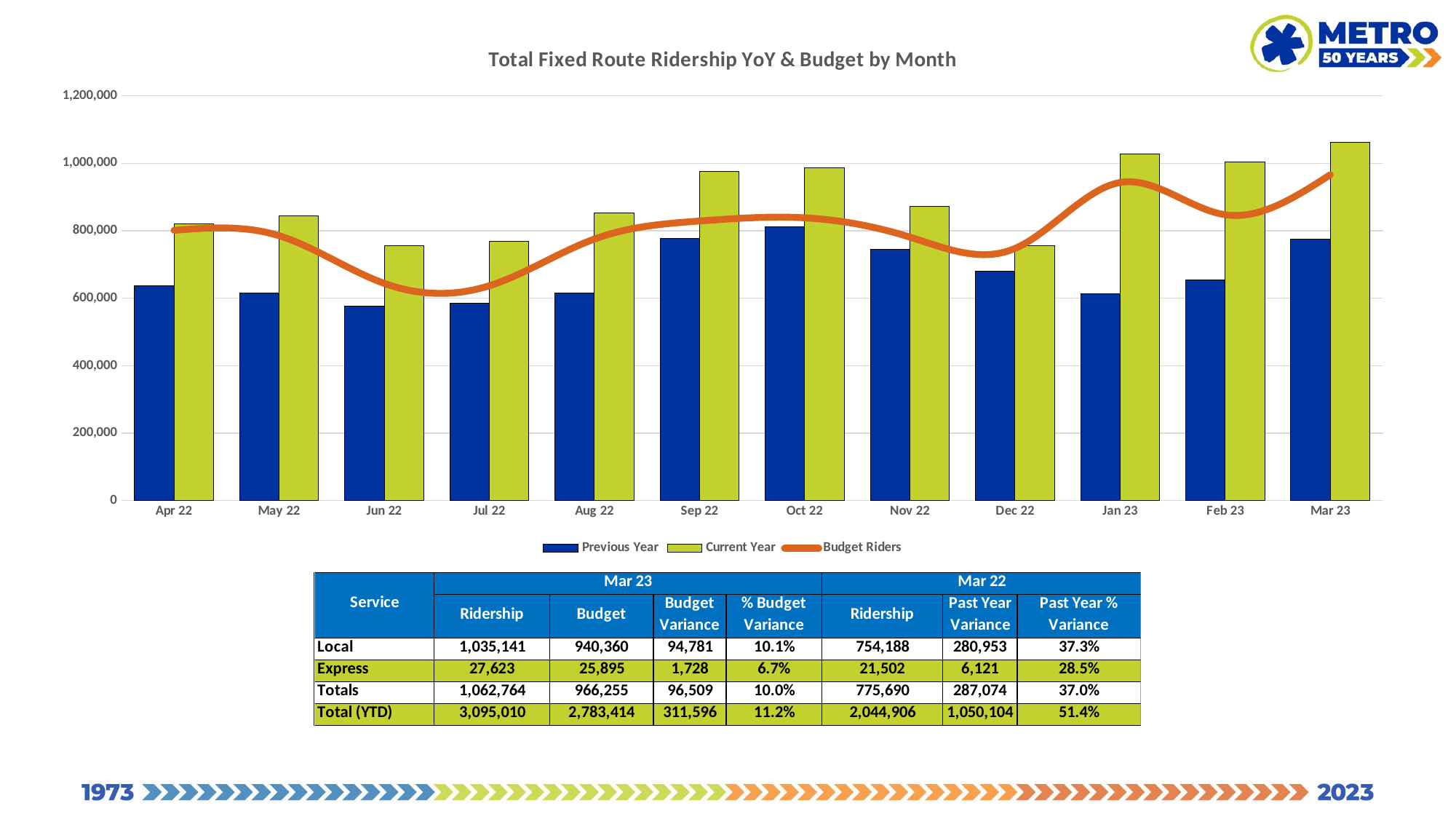
Is the Current Year value for Sep 22 greater or less than 1,000,000? less What kind of chart is shown on the slide? Bar chart with a line Which is larger for Sep 22: the Current Year bar or the Previous Year bar? Current Year Which series in the chart is drawn as an orange line? Budget Riders In which month is the Current Year bar the highest? Mar 23 What is the title of the chart? Total Fixed Route Ridership YoY & Budget by Month In which month is the Previous Year bar the highest? Oct 22 Do the Previous Year values rise or fall from Jun 22 to Oct 22? rise How many series does the chart legend list? 3 How many months are shown on the x axis of the chart? 12 Is the Current Year value for Mar 23 greater or less than 1,000,000? greater Is the Previous Year value for Jun 22 greater or less than 600,000? less